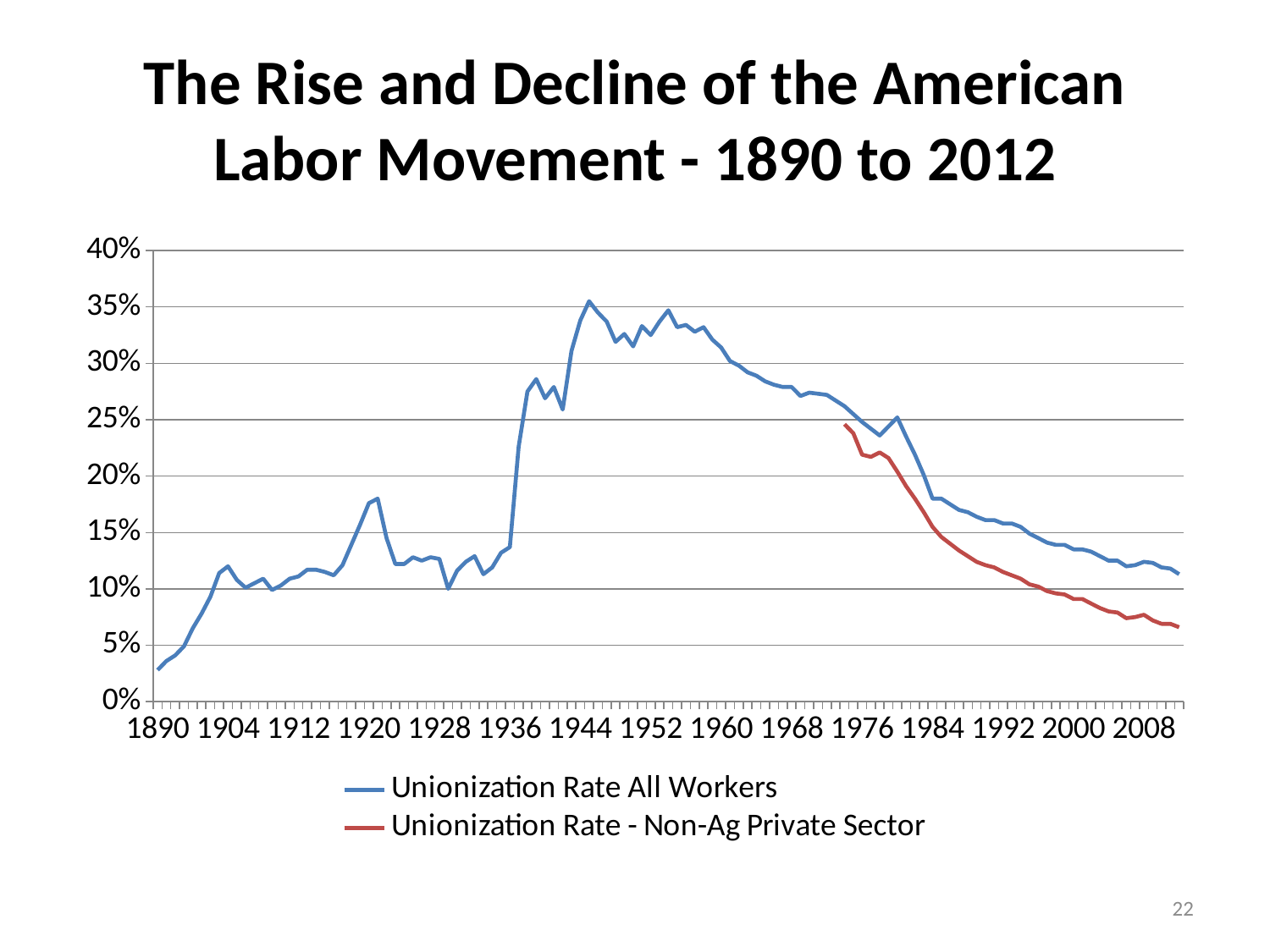
Is the value for Unionization Rate All Workers in 1968 greater or less than 25%? greater Which series is drawn in red? Unionization Rate - Non-Ag Private Sector Does the Unionization Rate All Workers series rise or fall between 1890 and 1904? Rise Does the Unionization Rate All Workers series rise or fall between 1976 and 2008? Fall What is the title of the chart on the slide? The Rise and Decline of the American Labor Movement - 1890 to 2012 Is the value for Unionization Rate - Non-Ag Private Sector in 2008 greater or less than 10%? less Is the highest value reached by the Unionization Rate All Workers series greater or less than 30%? greater How many series does the legend list? 2 What kind of chart is shown on the slide? Line chart In 2008, which series has the higher value: Unionization Rate All Workers or Unionization Rate - Non-Ag Private Sector? Unionization Rate All Workers